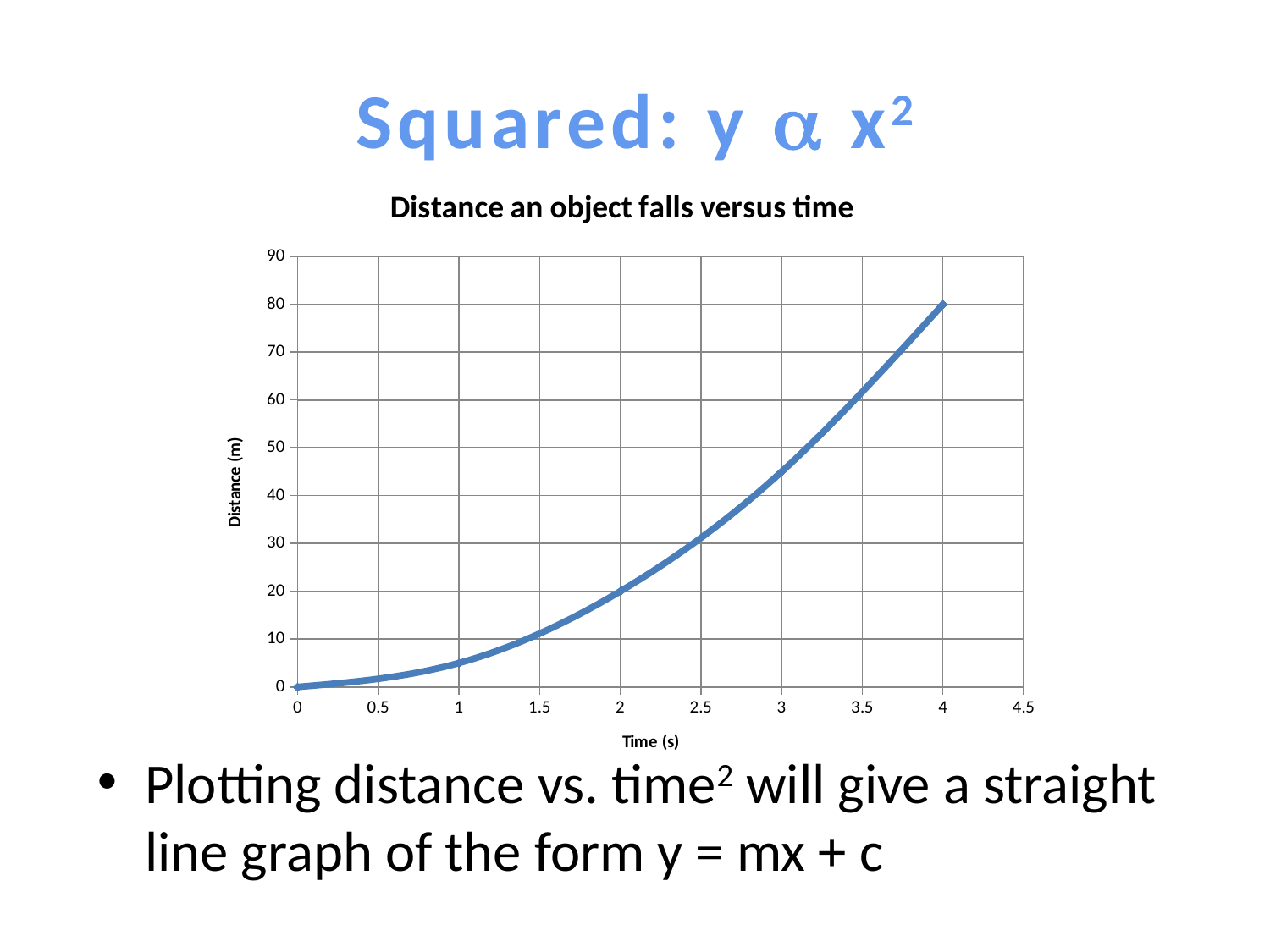
Is the distance at a time of 3 s greater or less than 40? greater What is the distance at a time of 0 s? 0 What is the title of the chart? Distance an object falls versus time What is the label of the vertical axis of the chart? Distance (m) What is the distance at a time of 2 s? 20 Does the distance rise or fall as time increases along the x axis? rises At which time shown is the distance lowest? 0 What kind of chart is shown on the slide? line chart At which time shown is the distance highest? 4 Is the distance at a time of 1 s greater or less than 10? less Which is larger, the distance at 3.5 s or the distance at 2.5 s? 3.5 s What is the distance at a time of 4 s? 80